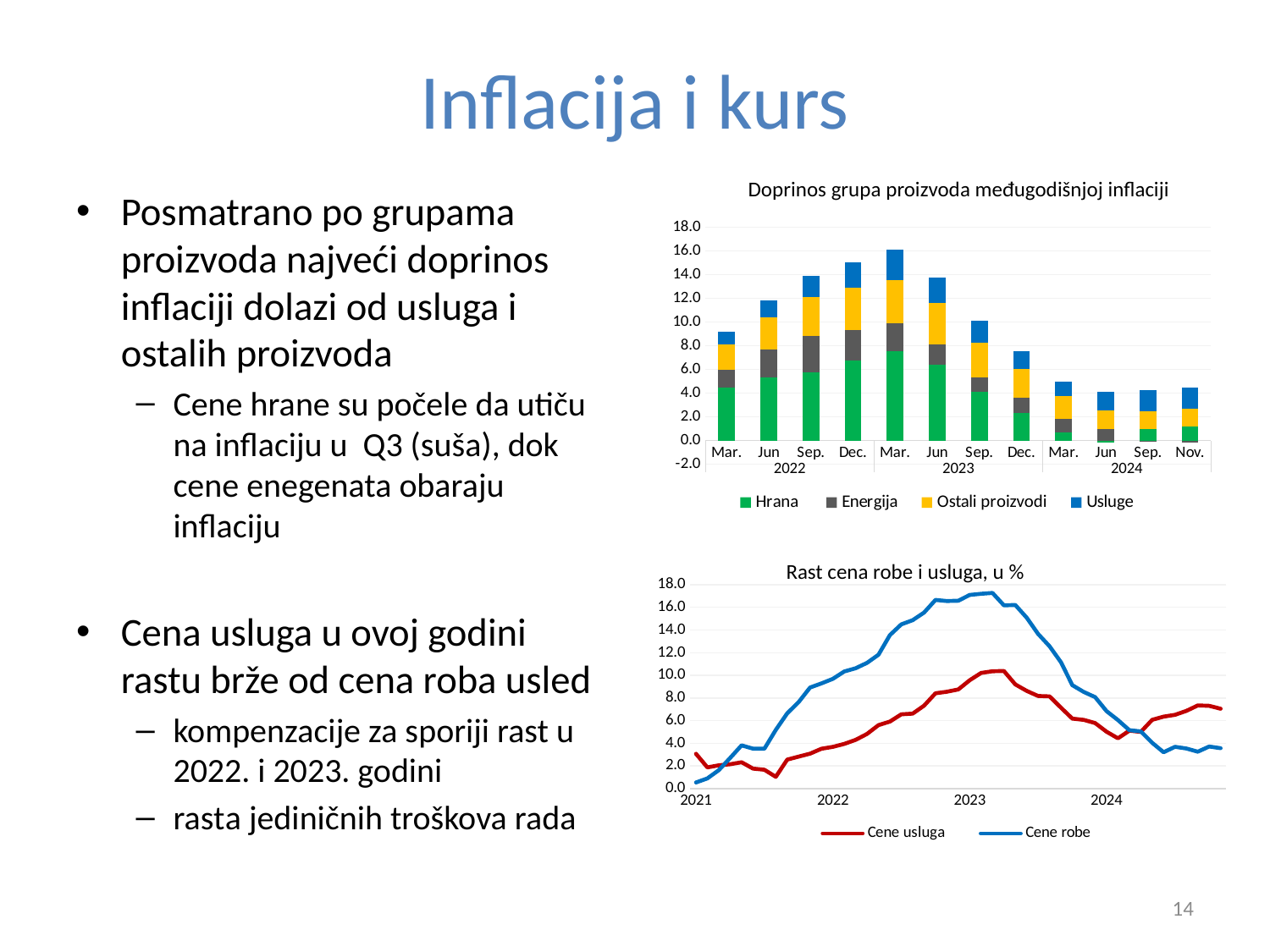
In the bottom chart "Rast cena robe i usluga, u %", does the Cene robe line rise or fall from early 2023 to 2024? Fall What kind of chart is the top chart titled "Doprinos grupa proizvoda međugodišnjoj inflaciji"? Stacked bar chart How many series does the legend of the bottom chart "Rast cena robe i usluga, u %" list? 2 In the top chart "Doprinos grupa proizvoda međugodišnjoj inflaciji", is the total of the Mar. 2023 bar greater or less than 14.0? greater In the top chart "Doprinos grupa proizvoda međugodišnjoj inflaciji", which series is shown in green? Hrana How many stacked bars are plotted in the top chart "Doprinos grupa proizvoda međugodišnjoj inflaciji"? 12 In the top chart "Doprinos grupa proizvoda međugodišnjoj inflaciji", is the total of the Dec. 2023 bar greater or less than 8.0? less In the bottom chart "Rast cena robe i usluga, u %", is the peak value of the Cene robe line greater or less than 16.0? greater In the top chart "Doprinos grupa proizvoda međugodišnjoj inflaciji", which period has the tallest stacked bar? Mar. 2023 How many series does the legend of the top chart "Doprinos grupa proizvoda međugodišnjoj inflaciji" list? 4 What kind of chart is the bottom chart titled "Rast cena robe i usluga, u %"? Line chart In the bottom chart "Rast cena robe i usluga, u %", which series is higher at the end of 2024, Cene usluga or Cene robe? Cene usluga